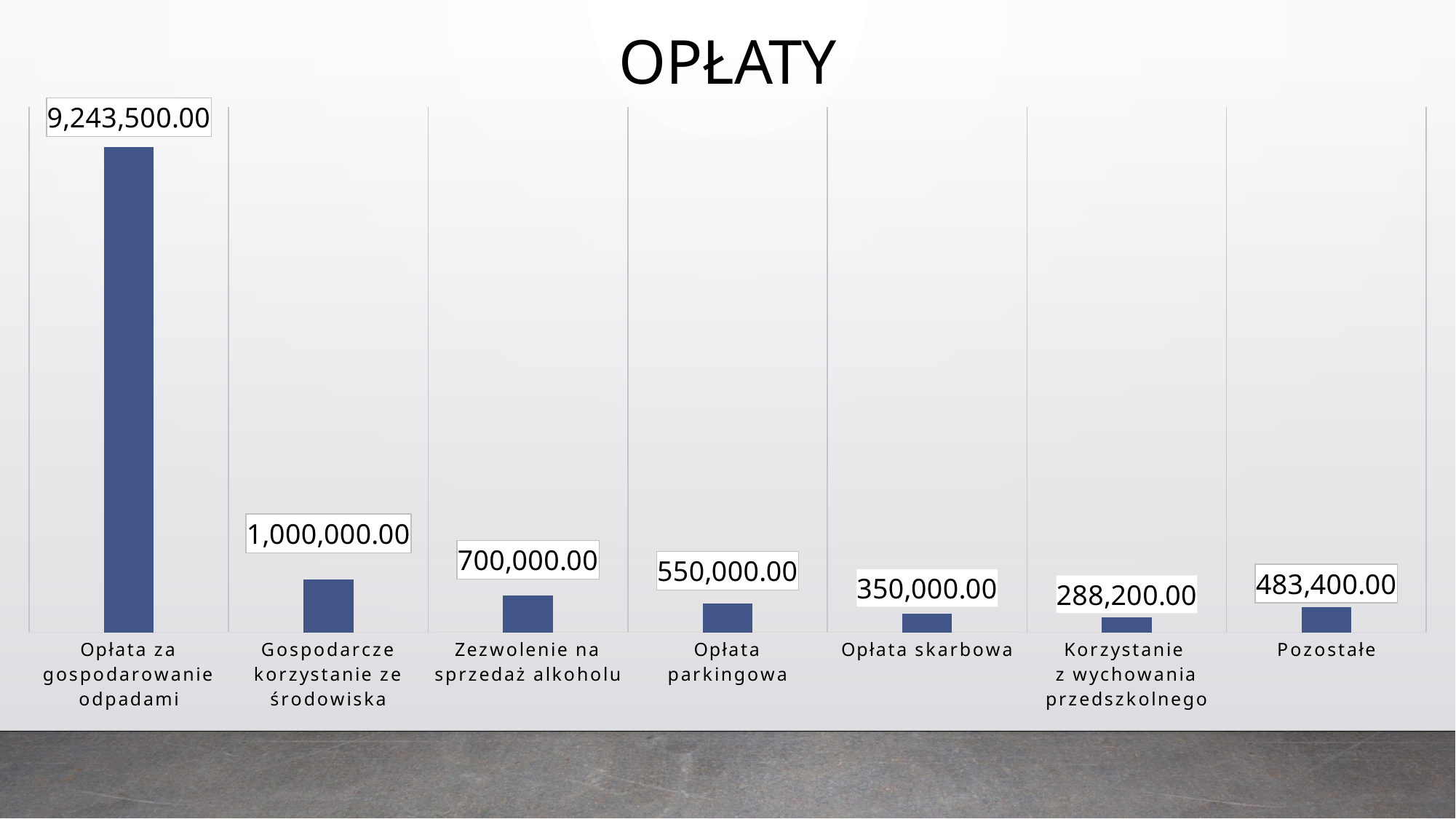
How many categories are shown in the chart? 7 What is the difference between the values for Gospodarcze korzystanie ze środowiska and Zezwolenie na sprzedaż alkoholu? 300,000.00 Which category has the highest value? Opłata za gospodarowanie odpadami What kind of chart is shown on the slide? Bar chart Which is larger, the value for Pozostałe or the value for Opłata skarbowa? Pozostałe What is the value for Opłata skarbowa? 350,000.00 Which category has the lowest value? Korzystanie z wychowania przedszkolnego What is the value for Opłata za gospodarowanie odpadami? 9,243,500.00 What is the title of the chart? OPŁATY What is the difference between the values for Opłata parkingowa and Opłata skarbowa? 200,000.00 What is the value for Pozostałe? 483,400.00 What is the value for Korzystanie z wychowania przedszkolnego? 288,200.00